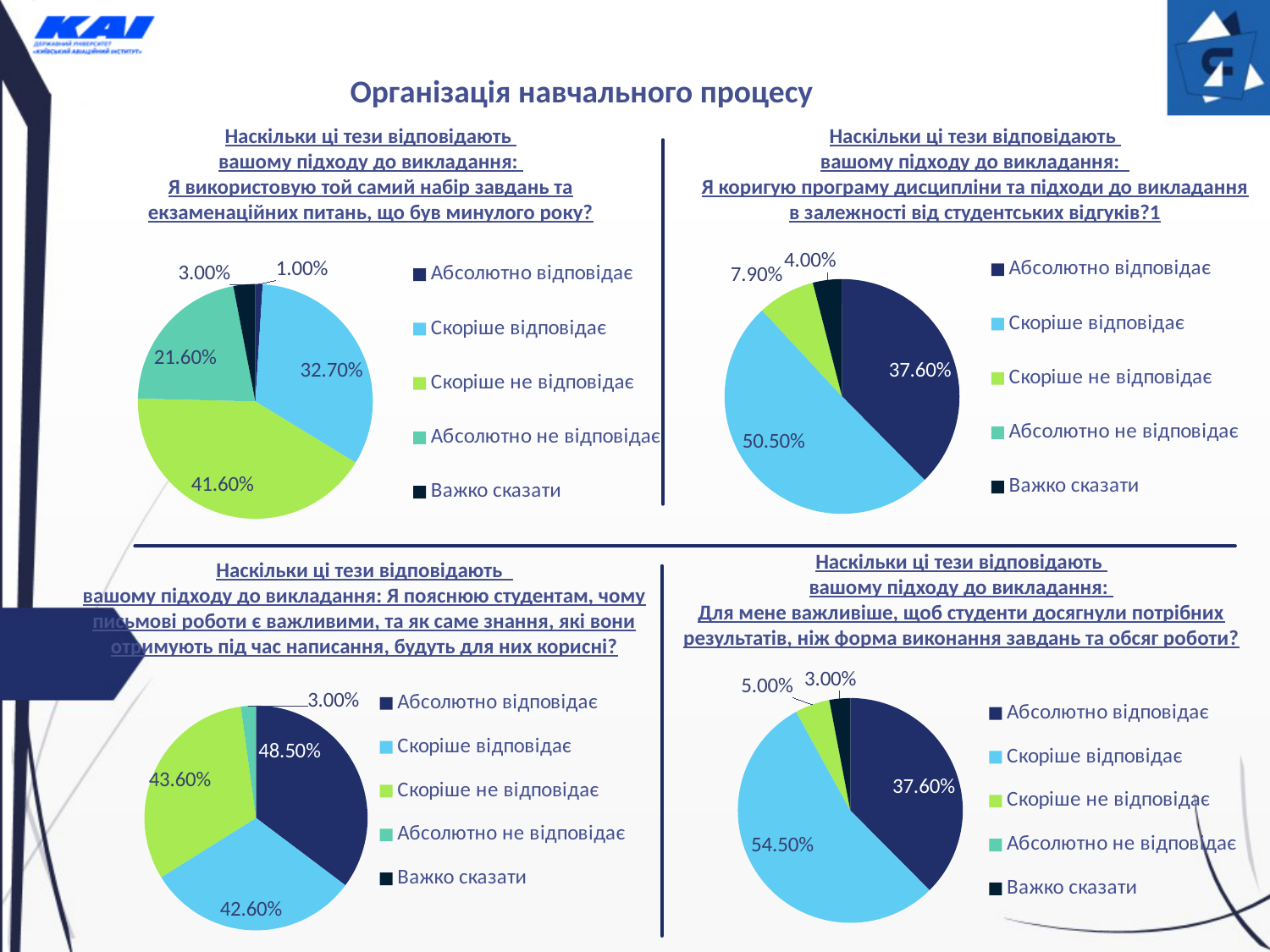
In the top-right pie chart, what share is labelled for 'Скоріше не відповідає'? 7.90% In the bottom-right pie chart (about results being more important than the form of tasks), what share is labelled for 'Скоріше відповідає'? 54.50% In the top-right pie chart (about adjusting the course programme based on student feedback), what share is labelled for 'Скоріше відповідає'? 50.50% In the bottom-left pie chart (about explaining to students why written work is important), what share is labelled for 'Абсолютно відповідає'? 48.50% In the top-left pie chart, what is the difference between the 'Скоріше не відповідає' and 'Скоріше відповідає' shares? 8.90% In the top-left pie chart, which category has the smallest share? Абсолютно відповідає How many entries does the legend of each pie chart list? 5 In the top-left pie chart, what share is labelled for 'Абсолютно не відповідає'? 21.60% In the bottom-right pie chart, which is larger: 'Абсолютно відповідає' or 'Скоріше відповідає'? Скоріше відповідає In the top-right pie chart, which category has the largest share? Скоріше відповідає In the top-left pie chart (about using the same set of tasks and exam questions as last year), what share is labelled for 'Скоріше не відповідає'? 41.60% What kind of charts are shown on the slide? Pie charts